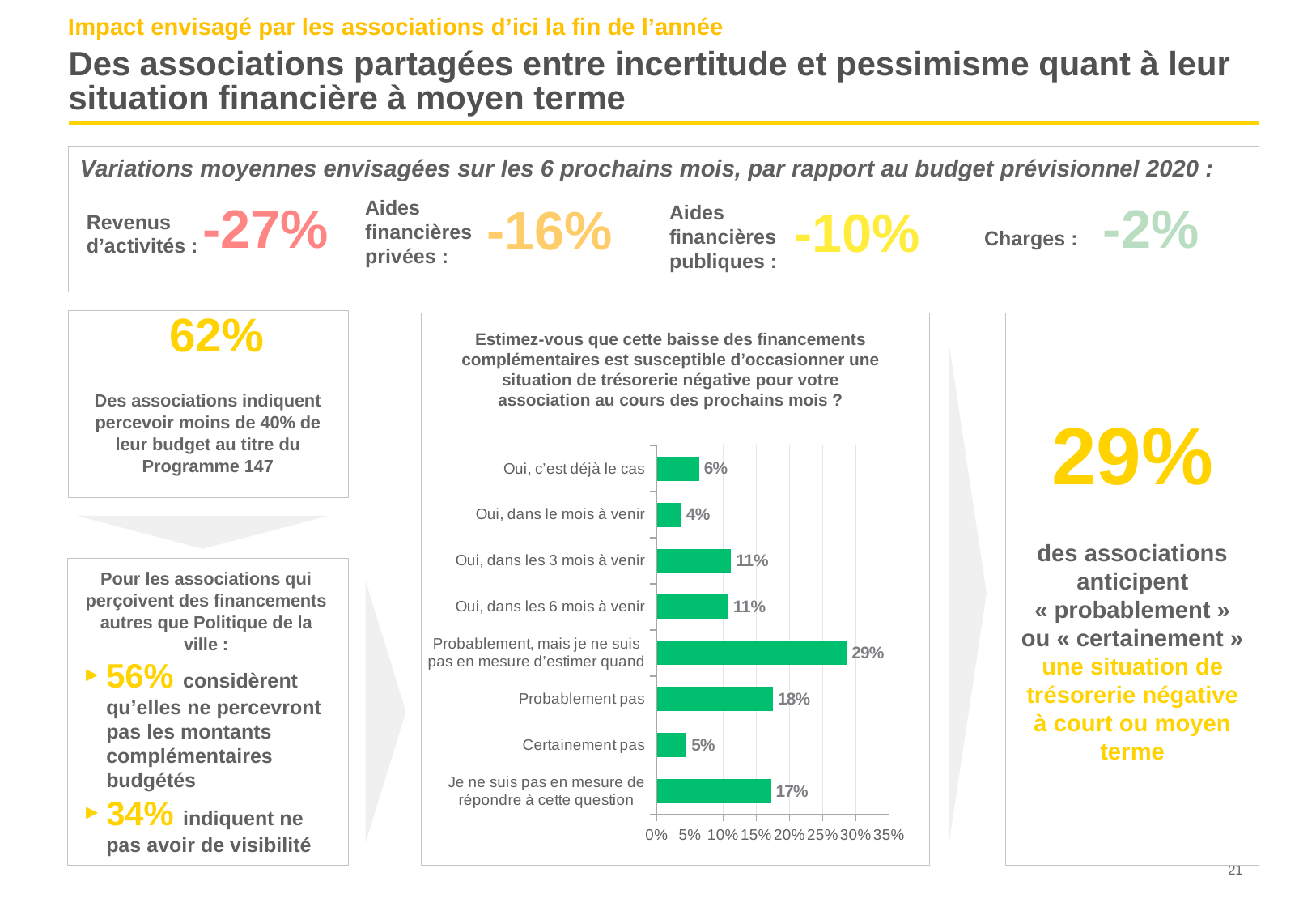
What is the value for "Je ne suis pas en mesure de répondre à cette question"? 17% What is the difference between the values for "Probablement, mais je ne suis pas en mesure d'estimer quand" and "Probablement pas"? 11% What is the maximum value shown on the chart's horizontal axis? 35% Which response category has the lowest value? Oui, dans le mois à venir Which response category has the highest value? Probablement, mais je ne suis pas en mesure d'estimer quand How many response categories does the chart show? 8 What is the value for "Oui, c'est déjà le cas"? 6% What kind of chart is shown on the slide? Bar chart Is the value for "Probablement pas" greater or less than 15%? greater What is the value for "Certainement pas"? 5% Which is larger: the value for "Probablement pas" or the value for "Je ne suis pas en mesure de répondre à cette question"? Probablement pas What is the value for "Probablement, mais je ne suis pas en mesure d'estimer quand"? 29%